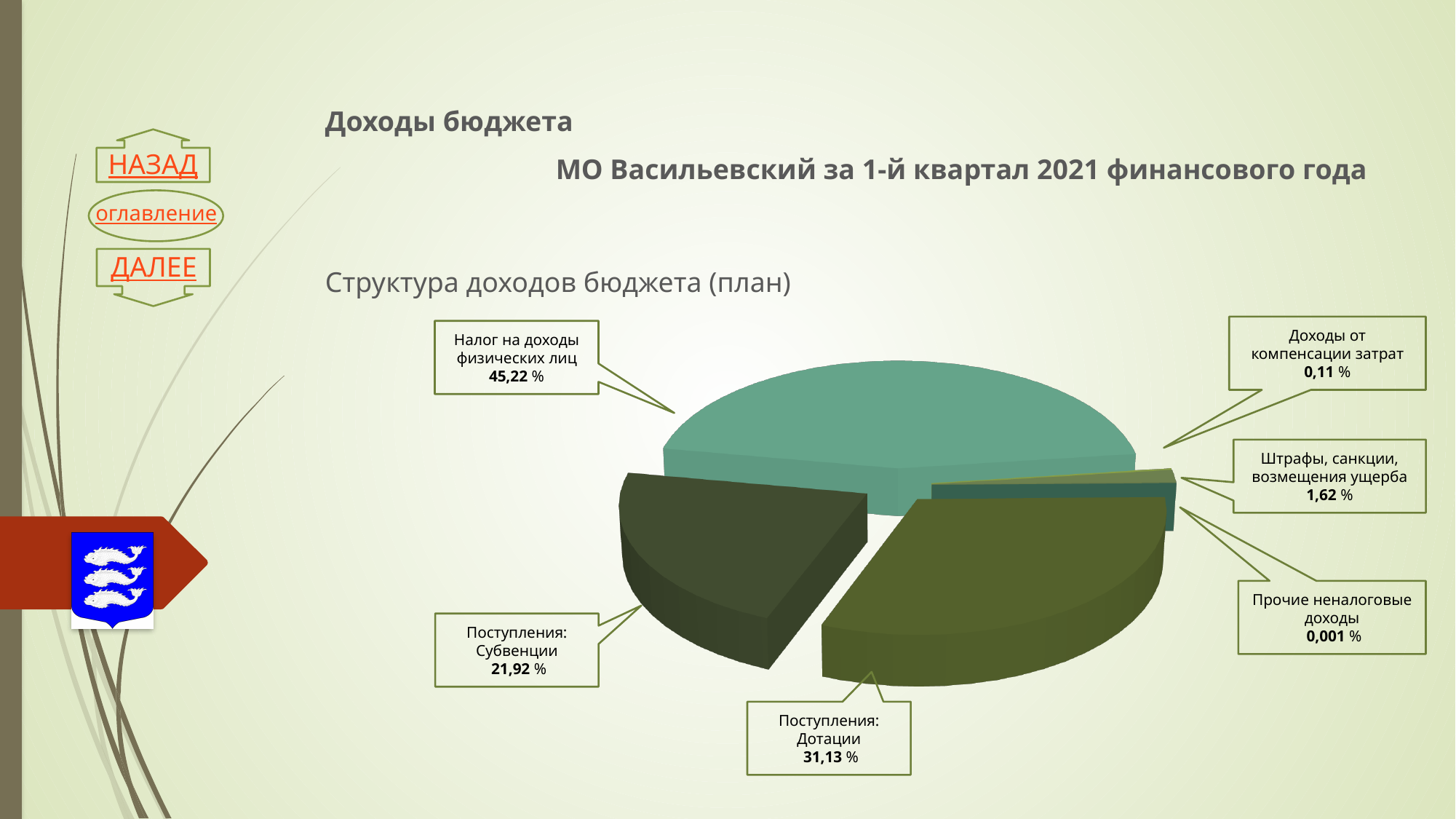
How many categories are shown in the pie chart? 6 What is the difference in percentage points between Налог на доходы физических лиц and Поступления: Дотации? 14,09 What is the share of Штрафы, санкции, возмещения ущерба in the pie chart? 1,62 % What is the title of the pie chart? Структура доходов бюджета (план) Which category has the largest share in the pie chart? Налог на доходы физических лиц What is the share of Поступления: Дотации in the pie chart? 31,13 % Which category has the smallest share in the pie chart? Прочие неналоговые доходы What is the share of Поступления: Субвенции in the pie chart? 21,92 % What is the share of Прочие неналоговые доходы in the pie chart? 0,001 % What is the share of Налог на доходы физических лиц in the pie chart? 45,22 % What is the share of Доходы от компенсации затрат in the pie chart? 0,11 % What kind of chart is shown on the slide? Pie chart